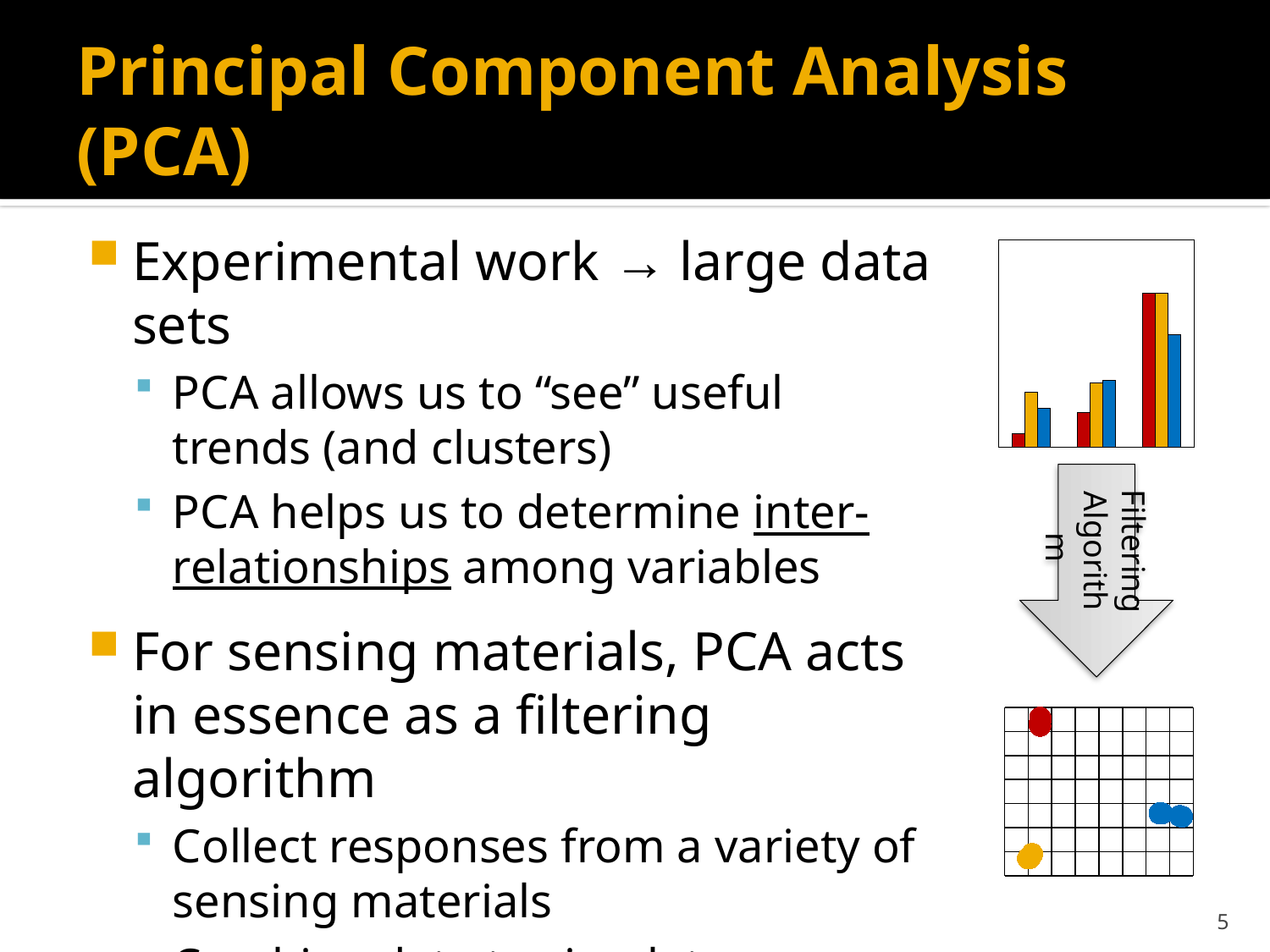
In the upper bar chart on the right, which group of bars (left, middle or right) has the shortest bars? left In the upper bar chart on the right, do the bar heights generally rise or fall from the left group to the right group? rise In the upper bar chart on the right, which colour bar is the tallest in the leftmost group? yellow In the upper bar chart on the right, is the red bar in the middle group taller or shorter than the blue bar in the middle group? shorter In the upper bar chart on the right, which colour bar is the tallest in the middle group? blue What three colours are used for the bars in the upper chart on the right? red, yellow and blue In the upper bar chart on the right, which colour bar is the shortest in the rightmost group? blue In the upper bar chart on the right, which group of bars (left, middle or right) has the tallest bars? right What kind of chart is the upper chart on the right side of the slide? bar chart In the upper bar chart on the right, how many bars are plotted in total? 9 In the upper bar chart on the right, how many bars are in each group? 3 In the upper bar chart on the right, how many groups of bars are there? 3